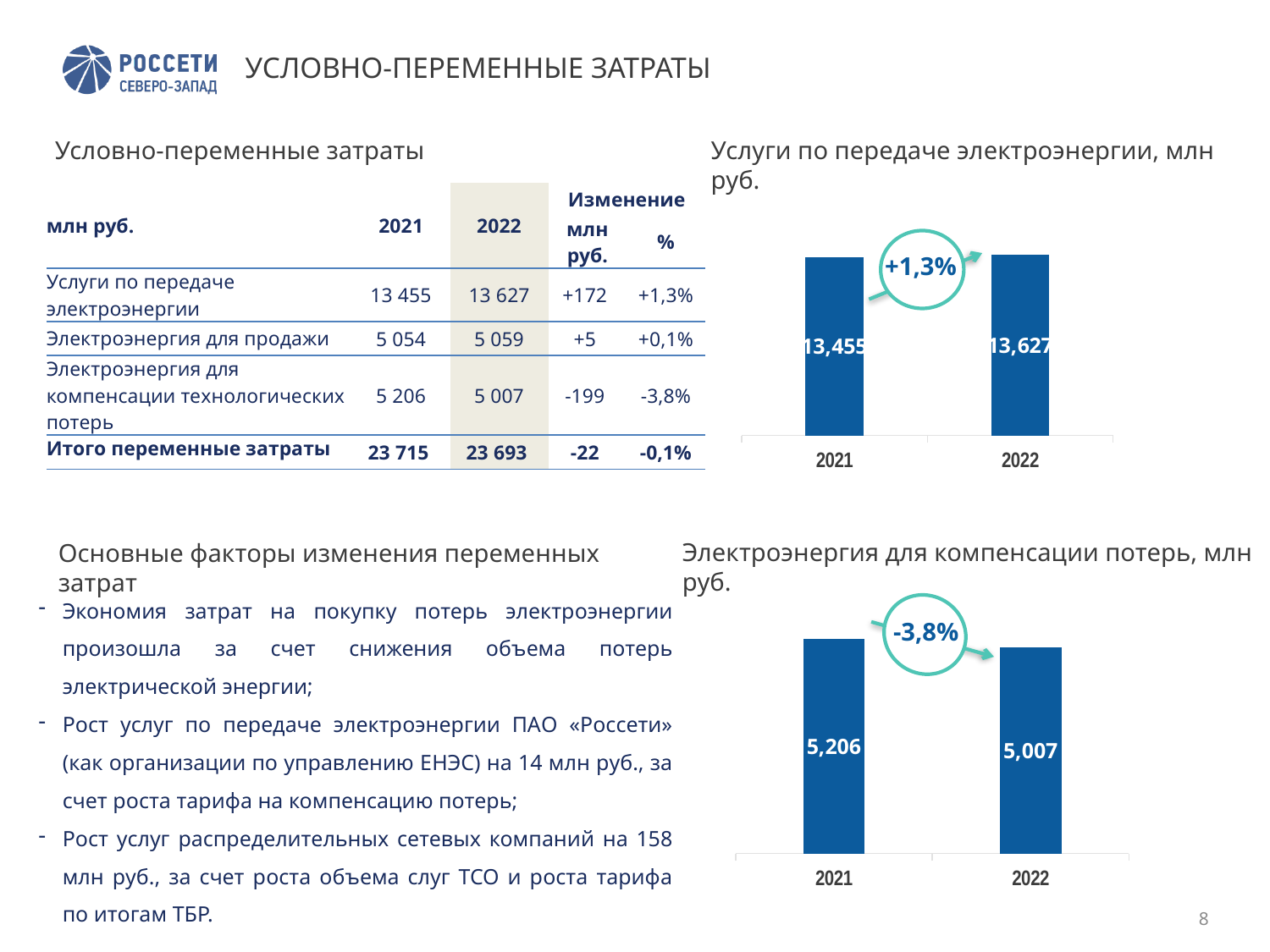
In the chart 'Услуги по передаче электроэнергии, млн руб.', what is the difference between the 2022 and 2021 values? 172 In the chart 'Услуги по передаче электроэнергии, млн руб.', what percentage change is shown in the circle annotation between the bars? +1,3% What type of chart is 'Электроэнергия для компенсации потерь, млн руб.'? bar chart In the chart 'Услуги по передаче электроэнергии, млн руб.', what is the value for 2022? 13,627 In the chart 'Электроэнергия для компенсации потерь, млн руб.', which year has the lower value? 2022 In the chart 'Электроэнергия для компенсации потерь, млн руб.', what is the difference between the 2021 and 2022 values? 199 In the chart 'Услуги по передаче электроэнергии, млн руб.', which year has the higher value? 2022 In the chart 'Электроэнергия для компенсации потерь, млн руб.', do the values rise or fall from 2021 to 2022? fall In the chart 'Услуги по передаче электроэнергии, млн руб.', what is the value for 2021? 13,455 In the chart 'Электроэнергия для компенсации потерь, млн руб.', what is the value for 2022? 5,007 In the chart 'Услуги по передаче электроэнергии, млн руб.', do the values rise or fall from 2021 to 2022? rise In the chart 'Электроэнергия для компенсации потерь, млн руб.', what is the value for 2021? 5,206